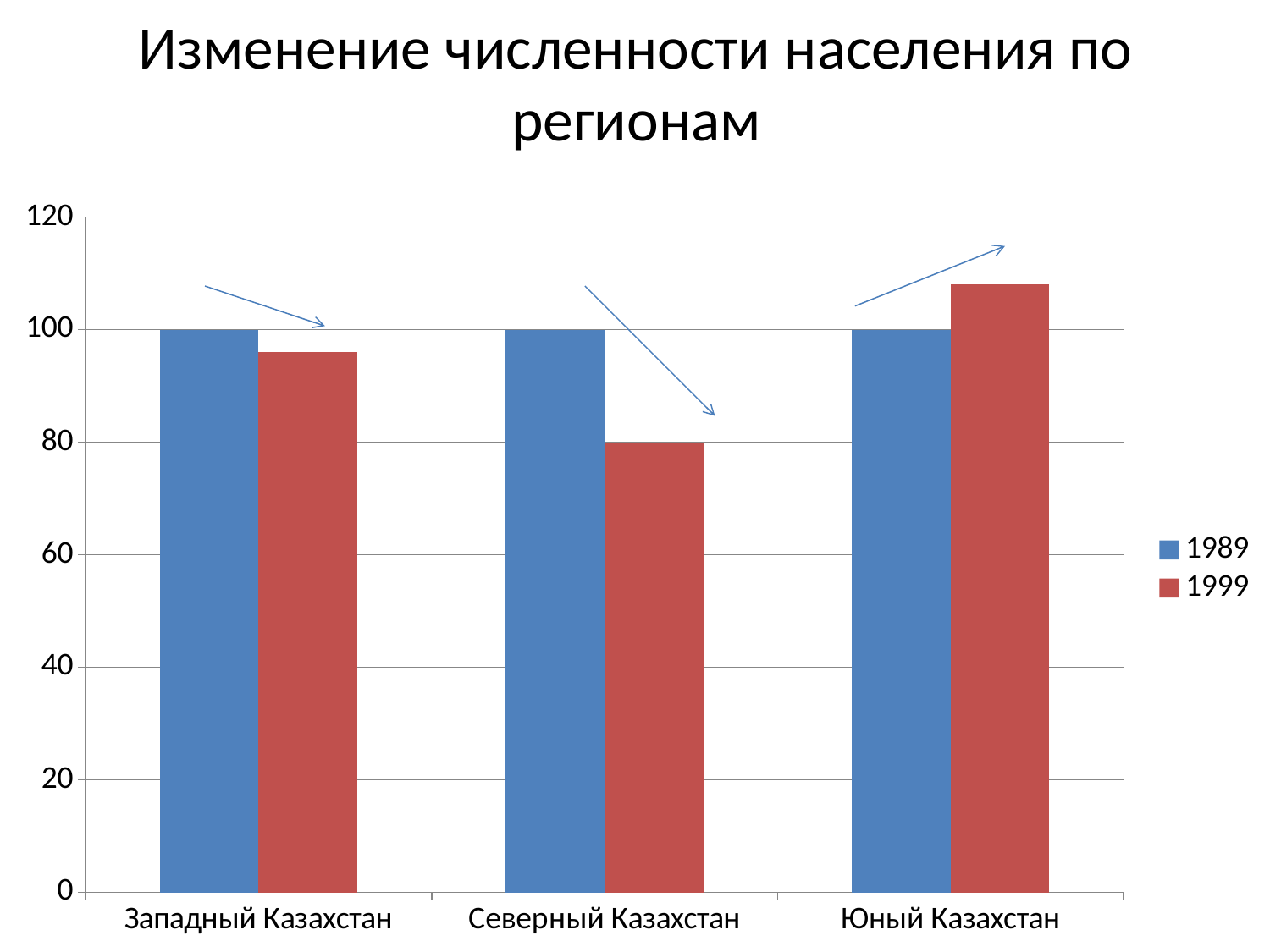
How many series does the legend list? 2 Is the 1999 value for Юный Казахстан greater or less than 100? greater How many regions (categories) are shown on the x axis? 3 What is the value for Юный Казахстан in 1989? 100 What type of chart is shown on the slide? bar chart By how much did the value for Северный Казахстан fall from 1989 to 1999? 20 What is the title of the chart? Изменение численности населения по регионам Which region has the highest value for 1999? Юный Казахстан Is the 1999 value for Западный Казахстан greater or less than 100? less What is the value for Северный Казахстан in 1999? 80 Which region has the lowest value for 1999? Северный Казахстан What is the value for Северный Казахстан in 1989? 100